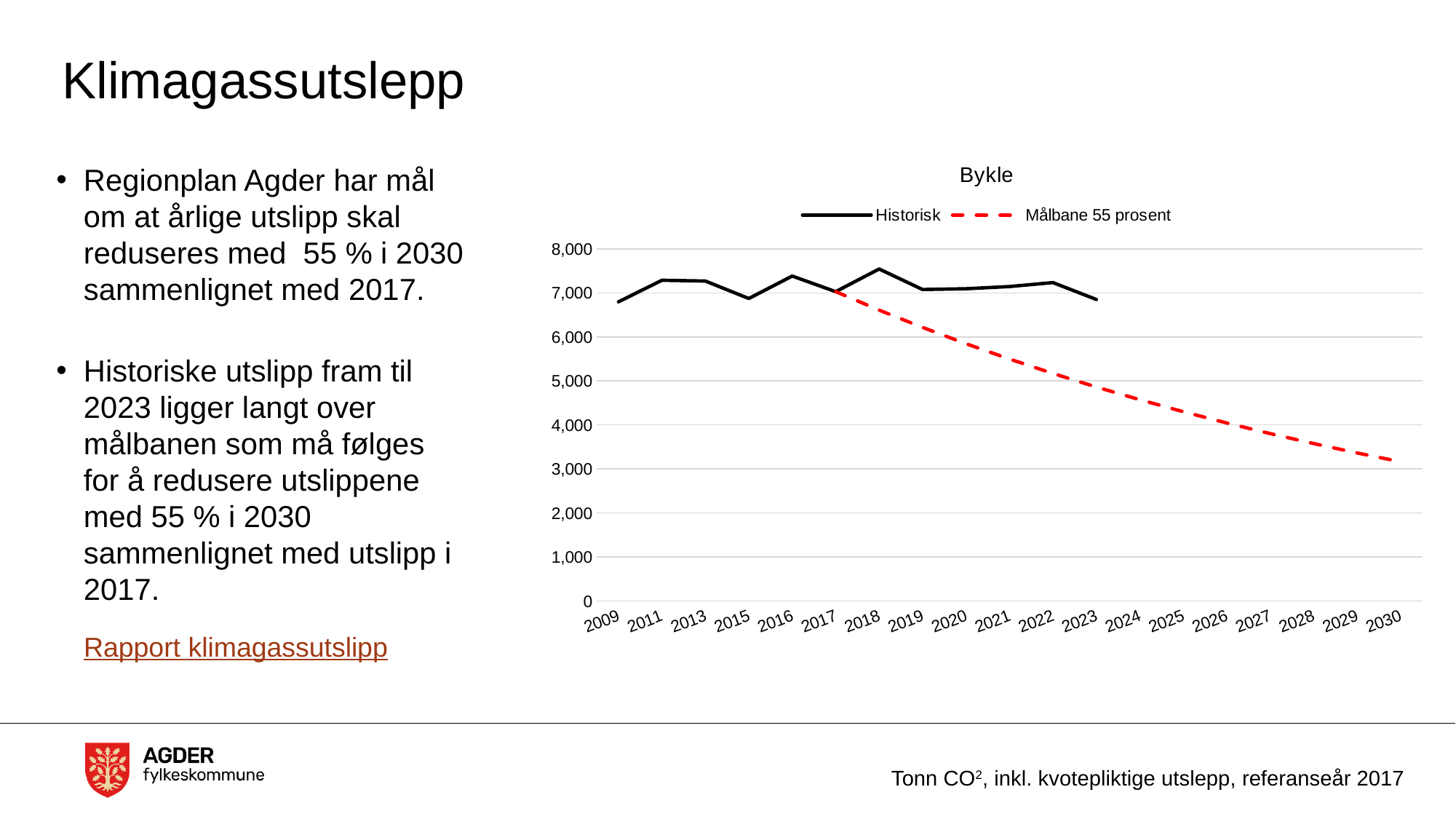
Which is larger: the Historisk value for 2018 or the Historisk value for 2015? 2018 Is the Målbane 55 prosent value for 2030 greater or less than 4,000? less How many series does the chart's legend list? 2 Is the Målbane 55 prosent value for 2022 greater or less than 6,000? less Is the Historisk value for 2011 greater or less than 7,000? greater Does the Målbane 55 prosent series rise or fall from 2017 to 2030? fall What are the two series named in the legend? Historisk and Målbane 55 prosent What is the title of the chart? Bykle How many years are labelled on the x axis of the chart? 19 What kind of chart is shown on the slide? line chart In which year does the Historisk series reach its highest value? 2018